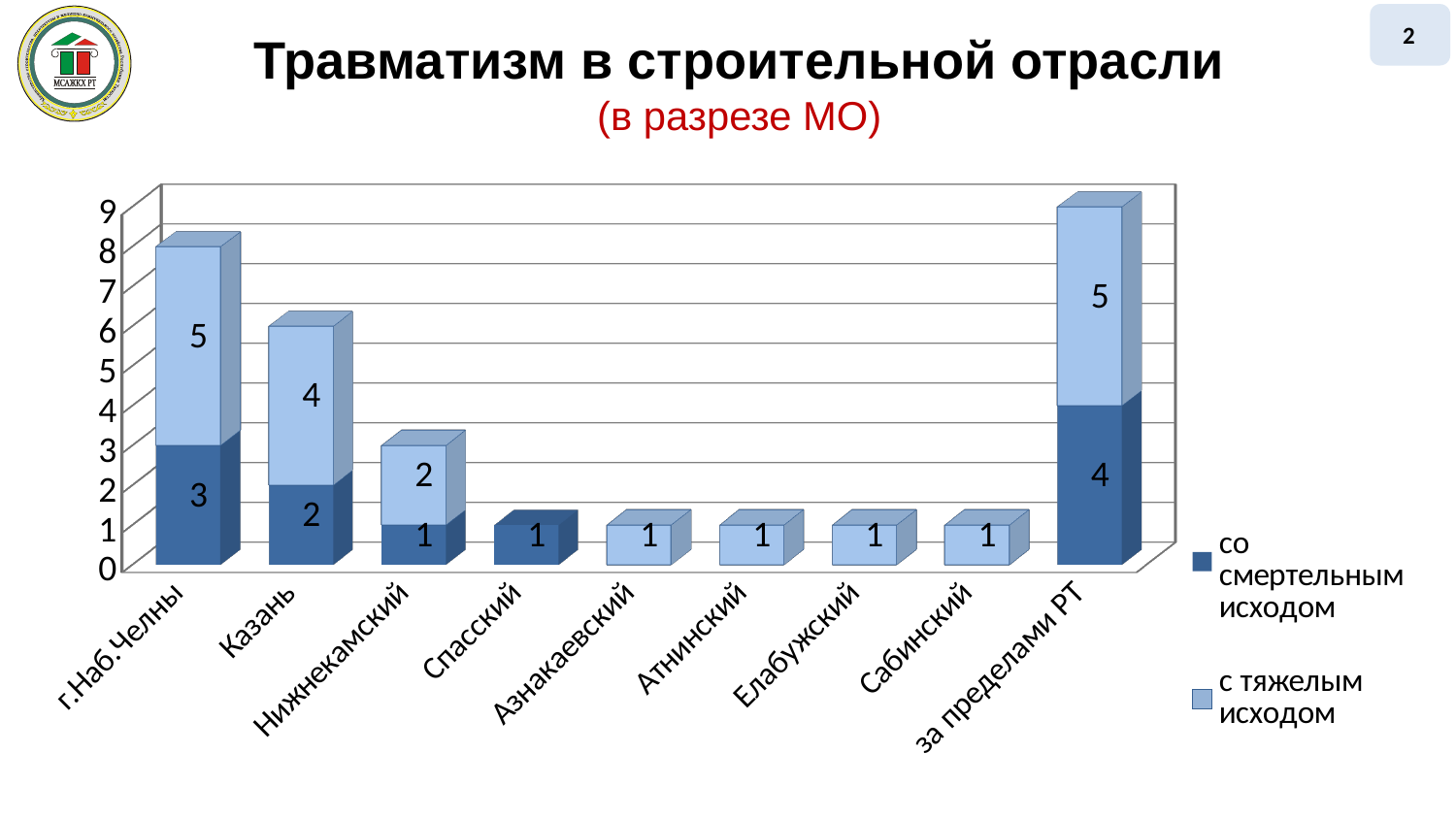
What is the total of the stacked bar for 'за пределами РТ'? 9 What is the value for 'со смертельным исходом' in г.Наб.Челны? 3 What kind of chart is shown on the slide? stacked bar chart How many series does the chart legend list? 2 How many categories are shown on the x axis of the chart? 9 What is the difference between the 'с тяжелым исходом' values for г.Наб.Челны and Нижнекамский? 3 What is the value for 'со смертельным исходом' for 'за пределами РТ'? 4 What is the total of the stacked bar for г.Наб.Челны? 8 Which is larger: the 'со смертельным исходом' value for Казань or for 'за пределами РТ'? за пределами РТ Which category has the highest total stacked bar? за пределами РТ Which legend entry is shown in the darker blue colour? со смертельным исходом What is the value for 'с тяжелым исходом' in Казань? 4